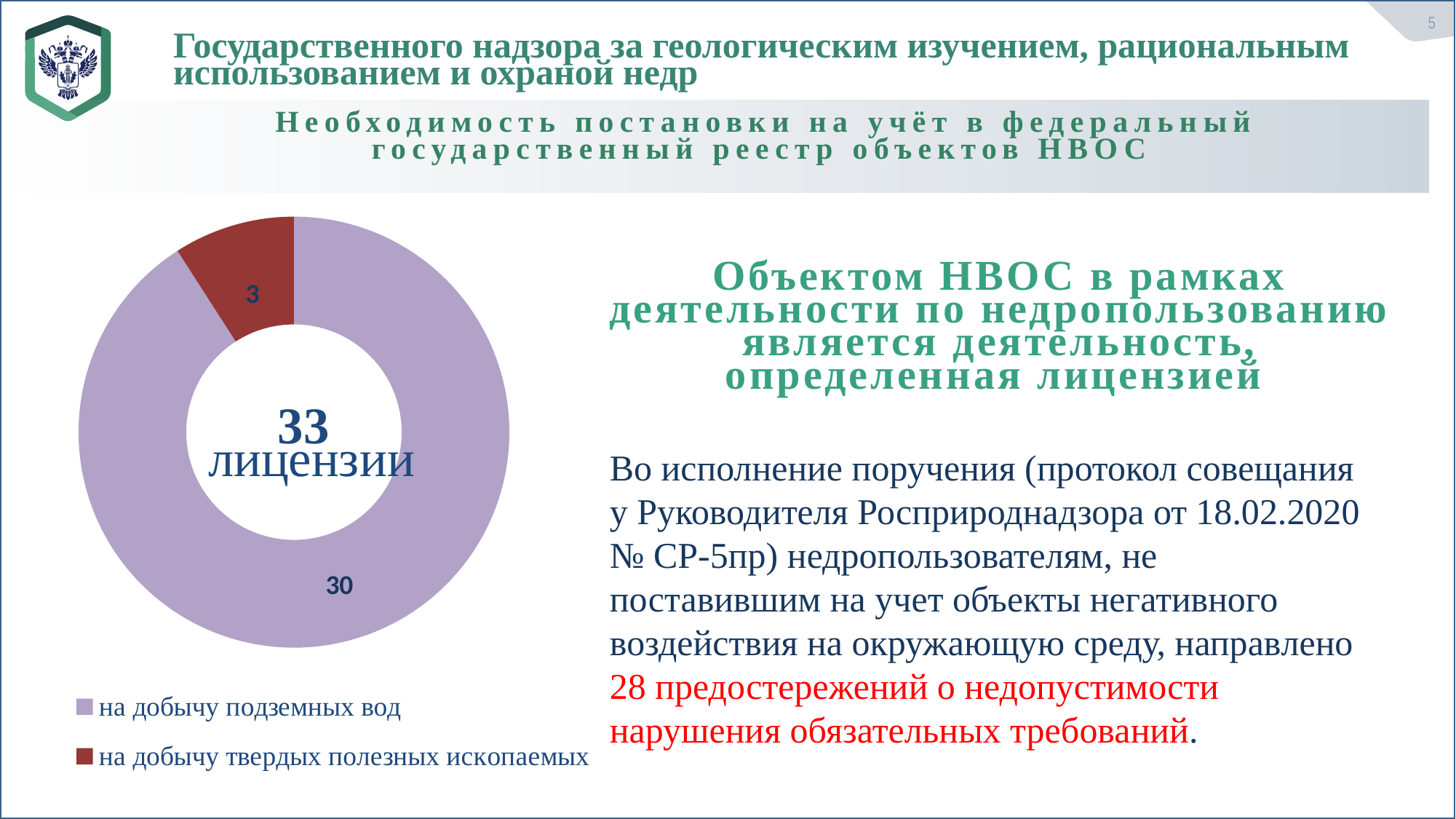
How many entries does the legend list? 2 What text is shown in the centre of the doughnut chart? 33 лицензии How many categories does the chart show? 2 What is the total of the two slices in the chart? 33 What type of chart is shown on the slide? doughnut (pie) chart What colour is the slice for "на добычу твердых полезных ископаемых"? dark red Which is larger: the value for "на добычу подземных вод" or for "на добычу твердых полезных ископаемых"? на добычу подземных вод What is the difference between the values for "на добычу подземных вод" and "на добычу твердых полезных ископаемых"? 27 Which category has the largest slice? на добычу подземных вод What is the value for "на добычу твердых полезных ископаемых"? 3 Which category has the smallest slice? на добычу твердых полезных ископаемых What is the value for "на добычу подземных вод"? 30